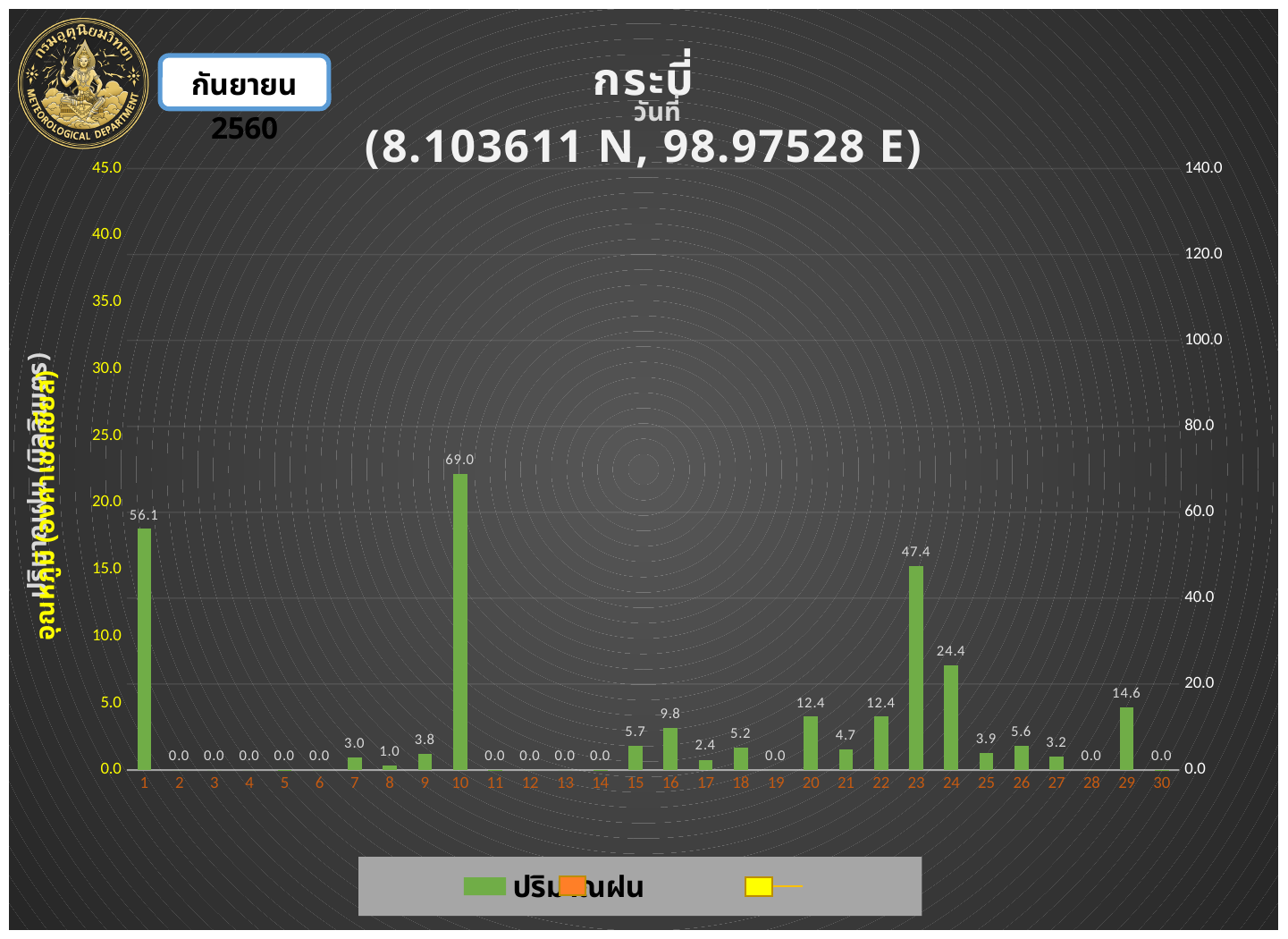
Which day has the highest value? 10 What is the value for day 23? 47.4 Which is larger, the value for day 16 or the value for day 15? day 16 What is the value for day 29? 14.6 What is the value for day 1? 56.1 What coordinates are given in the chart title? 8.103611 N, 98.97528 E What is the difference between the values for day 10 and day 23? 21.6 What is the difference between the values for day 24 and day 20? 12.0 What kind of chart is shown on the slide? bar chart How many days are shown on the x axis? 30 What is the value for day 10? 69.0 Which is larger, the value for day 1 or the value for day 23? day 1